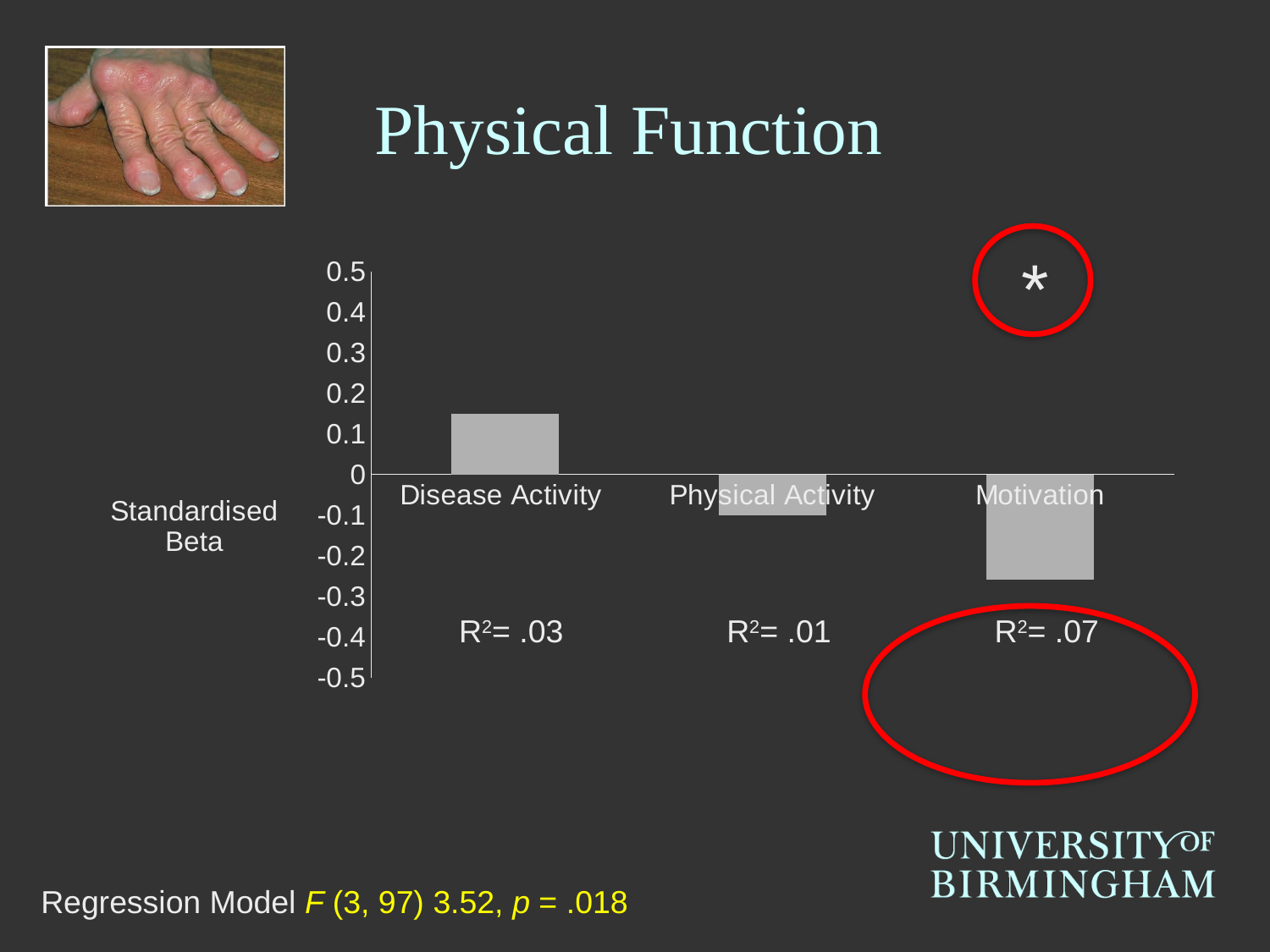
Which has the larger standardised beta, Disease Activity or Physical Activity? Disease Activity Which category has the highest standardised beta? Disease Activity What R² value is shown for Motivation? R²= .07 Which category has the lowest standardised beta? Motivation Is the standardised beta for Physical Activity greater or less than 0? less How many categories are plotted on the chart? 3 Is the standardised beta for Motivation greater or less than -0.1? less Which has the larger standardised beta, Physical Activity or Motivation? Physical Activity What kind of chart is shown on the slide? bar chart What is the label on the vertical axis of the chart? Standardised Beta Is the standardised beta for Disease Activity greater or less than 0.2? less